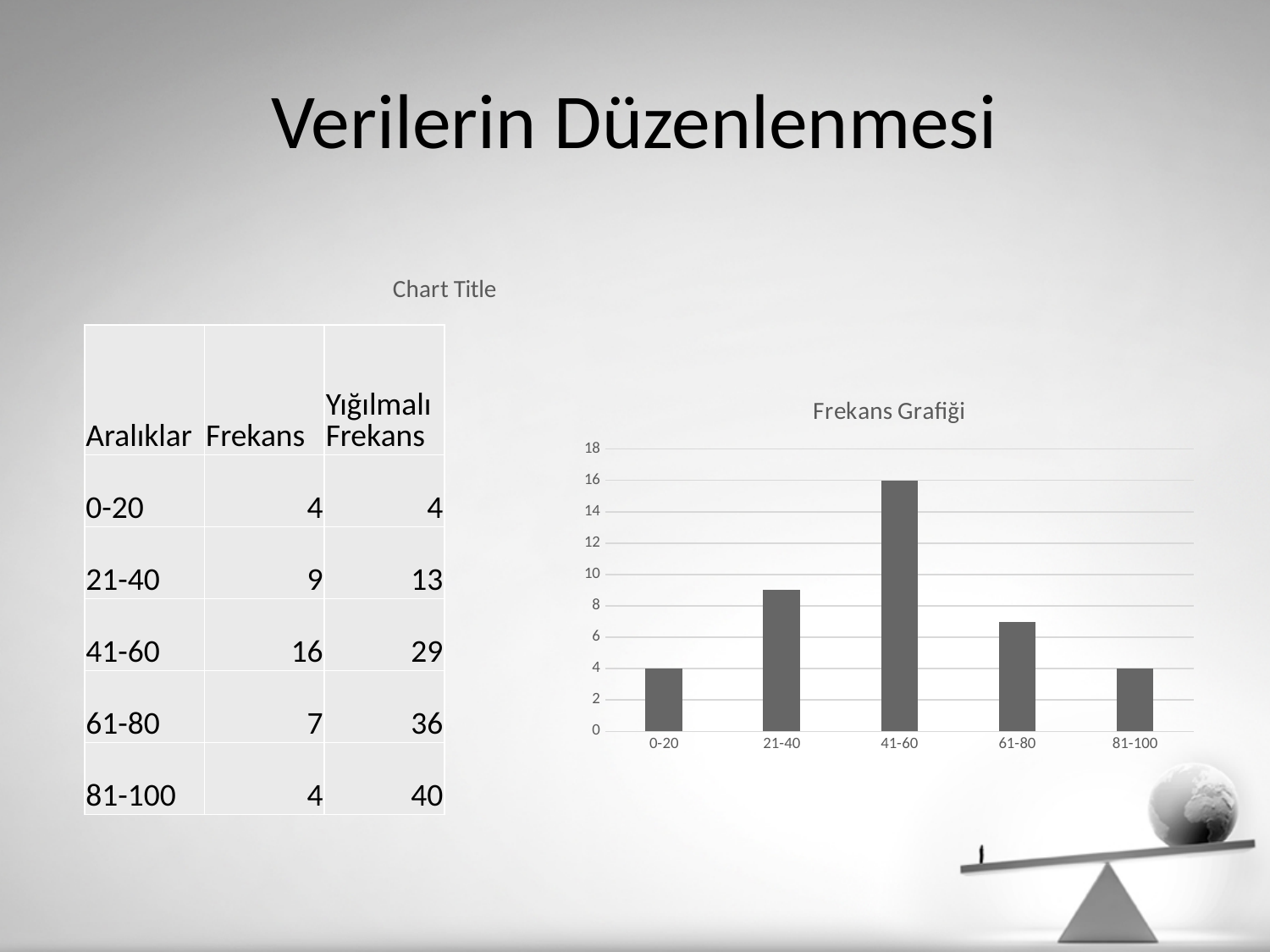
In the "Frekans Grafiği" chart, which category has the highest bar? 41-60 In the "Frekans Grafiği" chart, what is the value for 21-40? 9 In the "Frekans Grafiği" chart, what is the difference between the values for 41-60 and 0-20? 12 In the "Frekans Grafiği" chart, how many categories are shown on the x axis? 5 What is the title of the bar chart on the slide? Frekans Grafiği In the "Frekans Grafiği" chart, what is the value for 61-80? 7 In the "Frekans Grafiği" chart, is the value for 21-40 greater or less than 8? greater In the "Frekans Grafiği" chart, which is larger, the value for 21-40 or the value for 61-80? 21-40 What type of chart is "Frekans Grafiği"? bar chart In the "Frekans Grafiği" chart, what is the value for 41-60? 16 In the "Frekans Grafiği" chart, is the value for 61-80 greater or less than 8? less In the "Frekans Grafiği" chart, what is the value for 0-20? 4